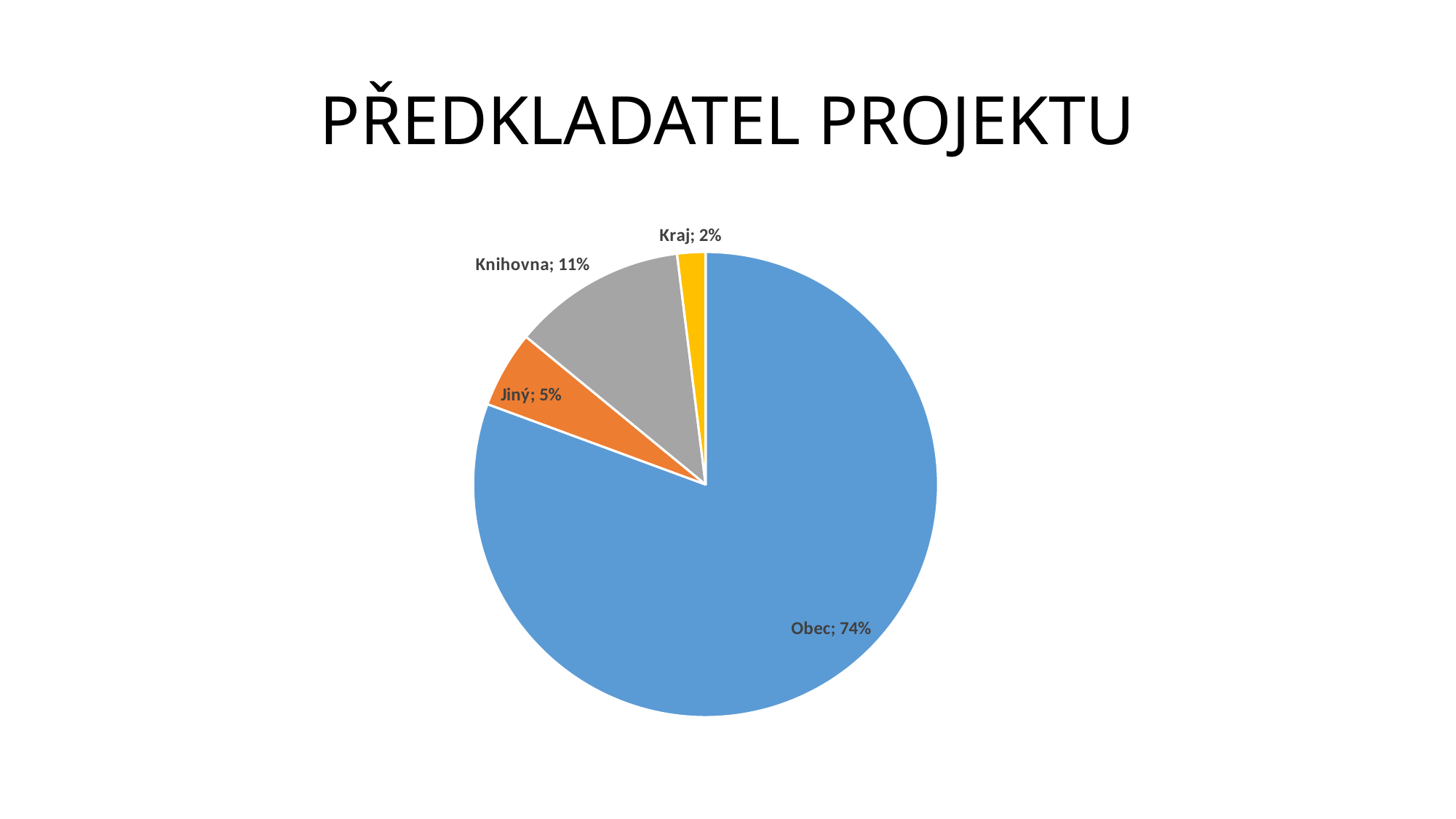
Which is larger, the slice for Jiný or the slice for Kraj? Jiný How many slices does the pie chart have? 4 What is the difference in percentage points between Knihovna and Jiný? 6 What is the title of the slide? PŘEDKLADATEL PROJEKTU Which category has the largest slice of the pie? Obec What share of the pie does Obec have? 74% What is the value shown for Kraj? 2% What kind of chart is shown on the slide? Pie chart What is the value shown for Jiný? 5% What is the difference in percentage points between Obec and Knihovna? 63 Which category has the smallest slice of the pie? Kraj What is the value shown for Knihovna? 11%